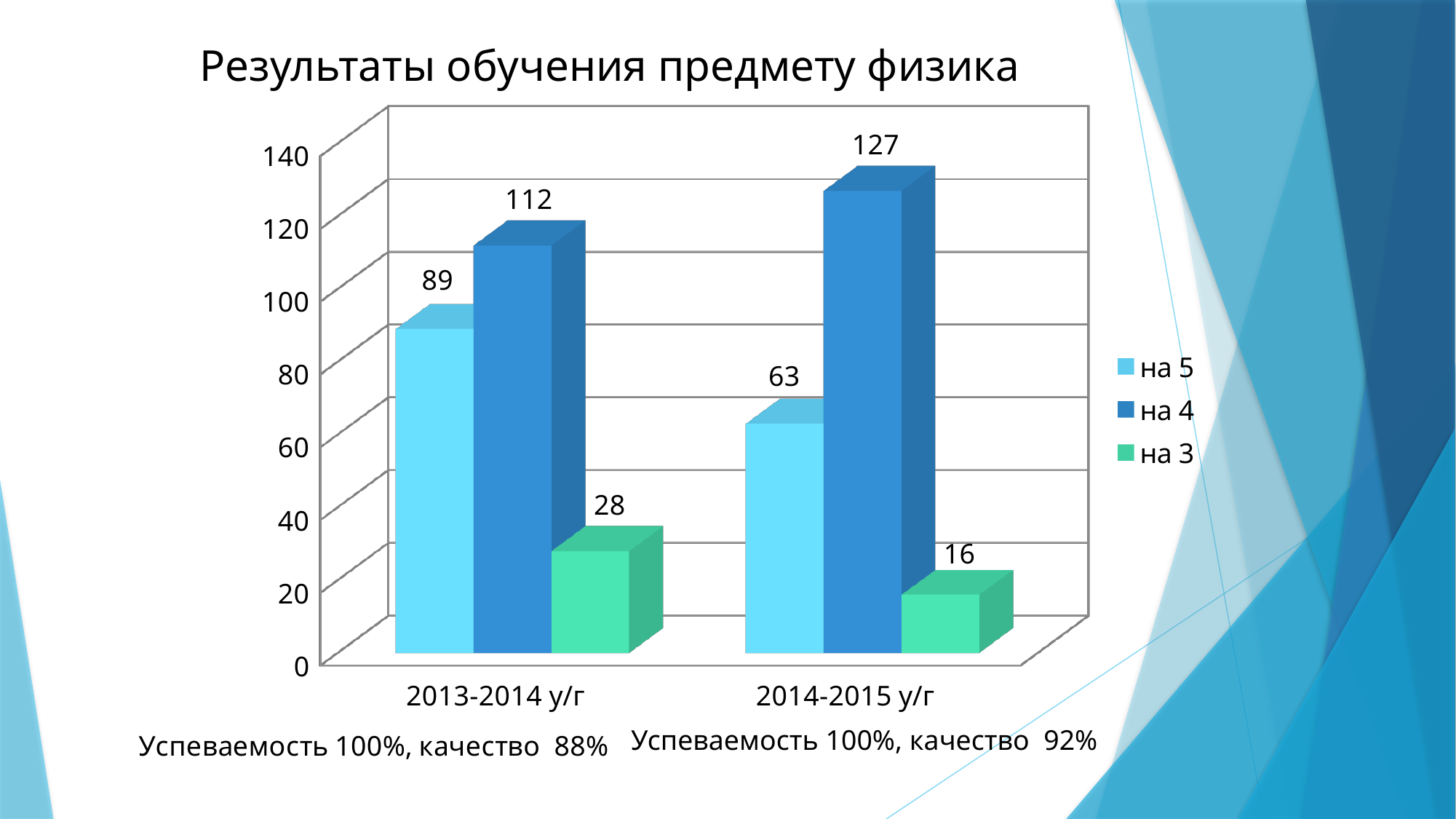
What kind of chart is shown on the slide? bar chart How many categories are shown on the x axis? 2 Which series has the highest value in 2014-2015 у/г? на 4 What is the value for "на 5" in 2013-2014 у/г? 89 How many series does the legend list? 3 What is the value for "на 5" in 2014-2015 у/г? 63 What is the value for "на 3" in 2013-2014 у/г? 28 Which is larger: "на 5" in 2013-2014 у/г or "на 5" in 2014-2015 у/г? 2013-2014 у/г What is the difference between the "на 4" values for 2014-2015 у/г and 2013-2014 у/г? 15 Which series has the lowest value in 2013-2014 у/г? на 3 What is the title of the chart? Результаты обучения предмету физика What is the value for "на 4" in 2014-2015 у/г? 127